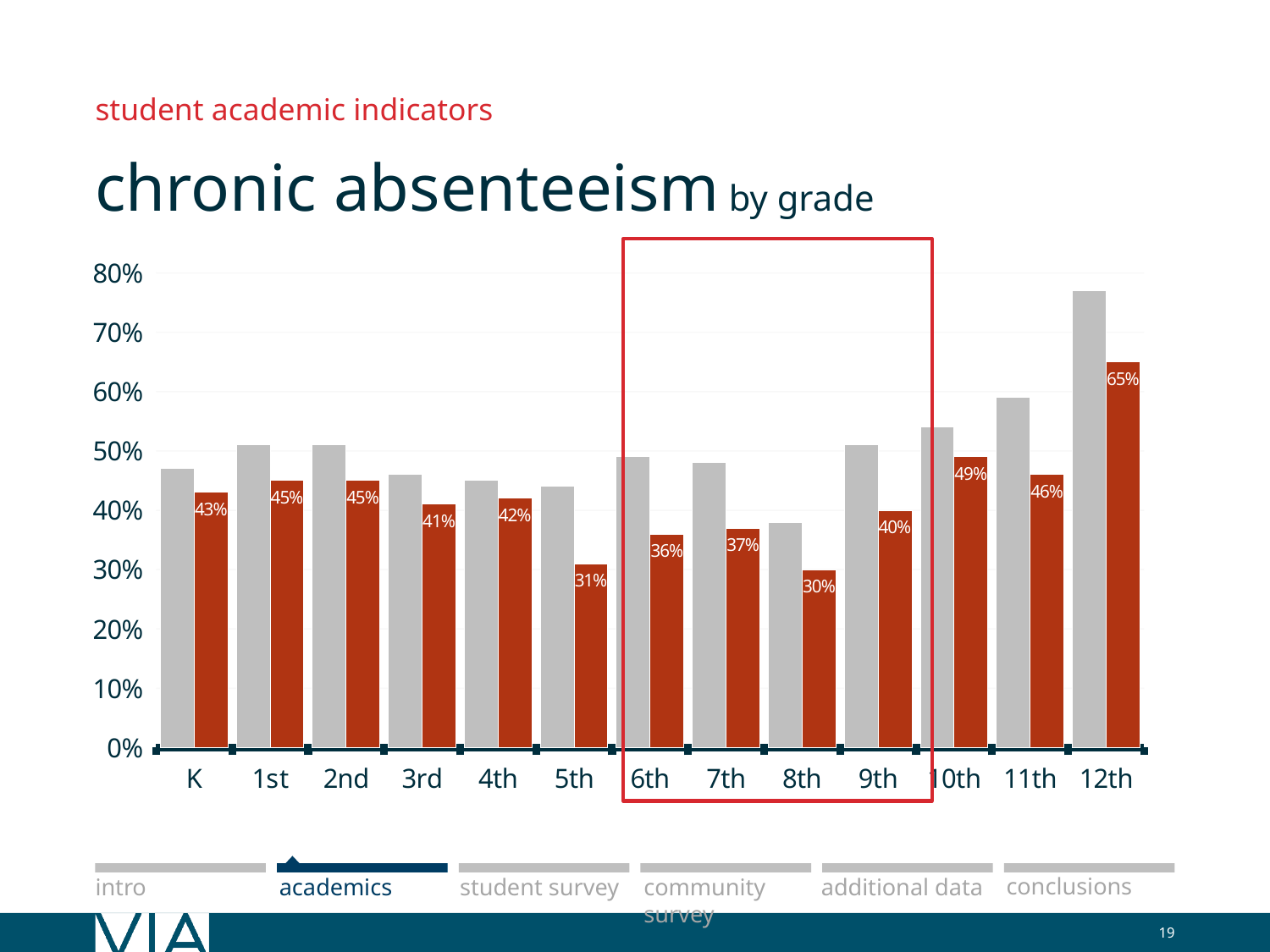
Which grade has the highest labelled red-bar value? 12th Which has the larger labelled red-bar value, 10th grade or 11th grade? 10th Is the gray bar for 8th grade greater or less than 40%? less What is the difference between the labelled red-bar values for 12th grade and 8th grade? 35 percentage points What is the labelled value of the red bar for kindergarten (K)? 43% Which grade has the lowest labelled red-bar value? 8th Is the gray bar for 12th grade greater or less than 70%? greater How many grade categories are shown on the x axis? 13 What is the labelled value of the red bar for 12th grade? 65% What is the labelled value of the red bar for 8th grade? 30% What kind of chart is shown on the slide? Bar chart Which grades are enclosed by the red outline box on the chart? 6th, 7th, 8th and 9th